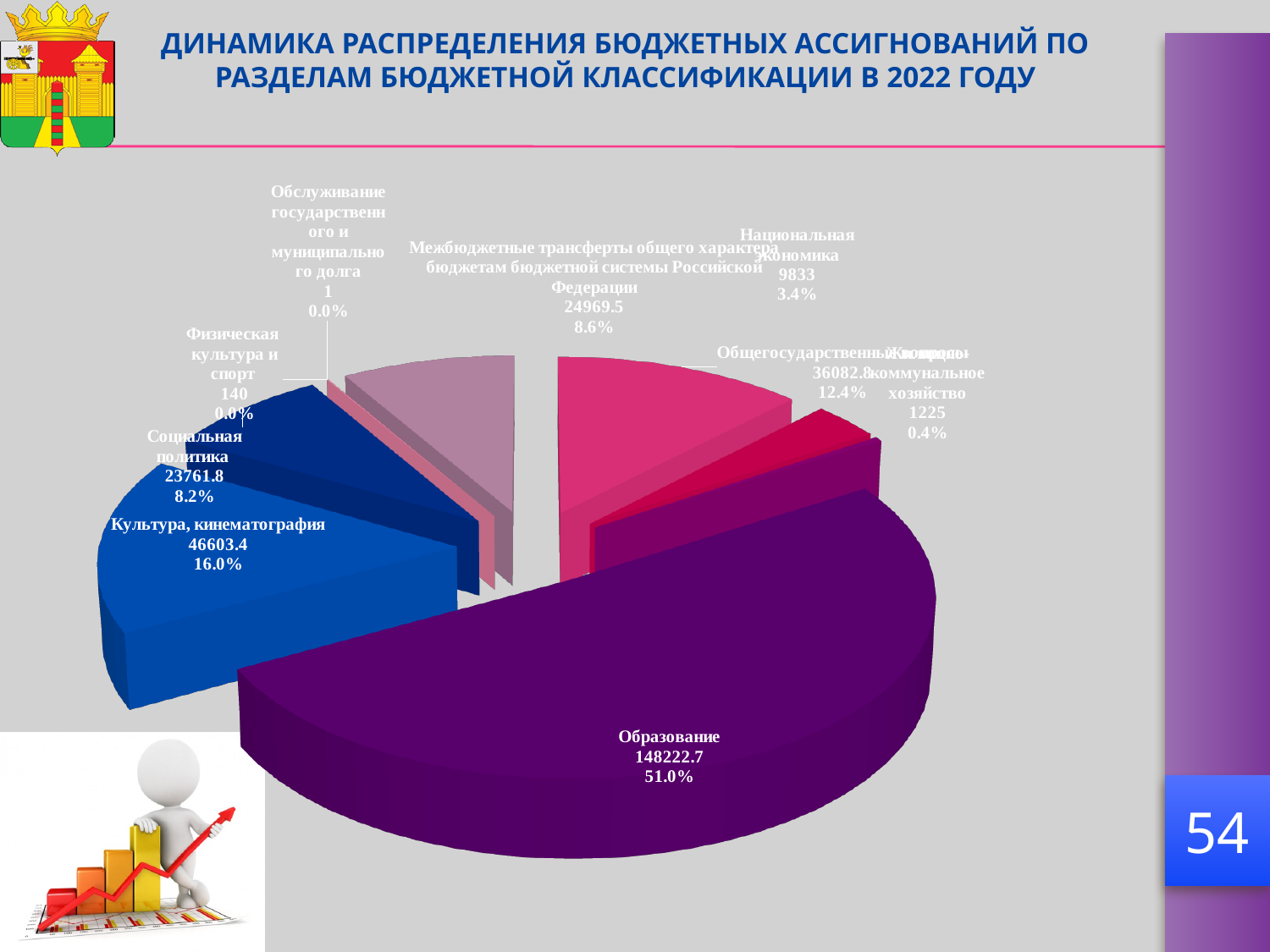
What share of the pie does Социальная политика represent? 8.2% What share of the pie does Образование represent? 51.0% What is the value shown for Образование? 148222.7 Which is larger, the value for Межбюджетные трансферты общего характера or the value for Национальная экономика? Межбюджетные трансферты общего характера How many categories are shown in the pie chart? 9 What year does the chart title refer to? 2022 Which category has the largest slice of the pie? Образование What is the difference between the values for Общегосударственные вопросы and Социальная политика? 12321 What is the value shown for Национальная экономика? 9833 What is the value shown for Культура, кинематография? 46603.4 Which category has the smallest value in the pie chart? Обслуживание государственного и муниципального долга What kind of chart is shown on the slide? pie chart